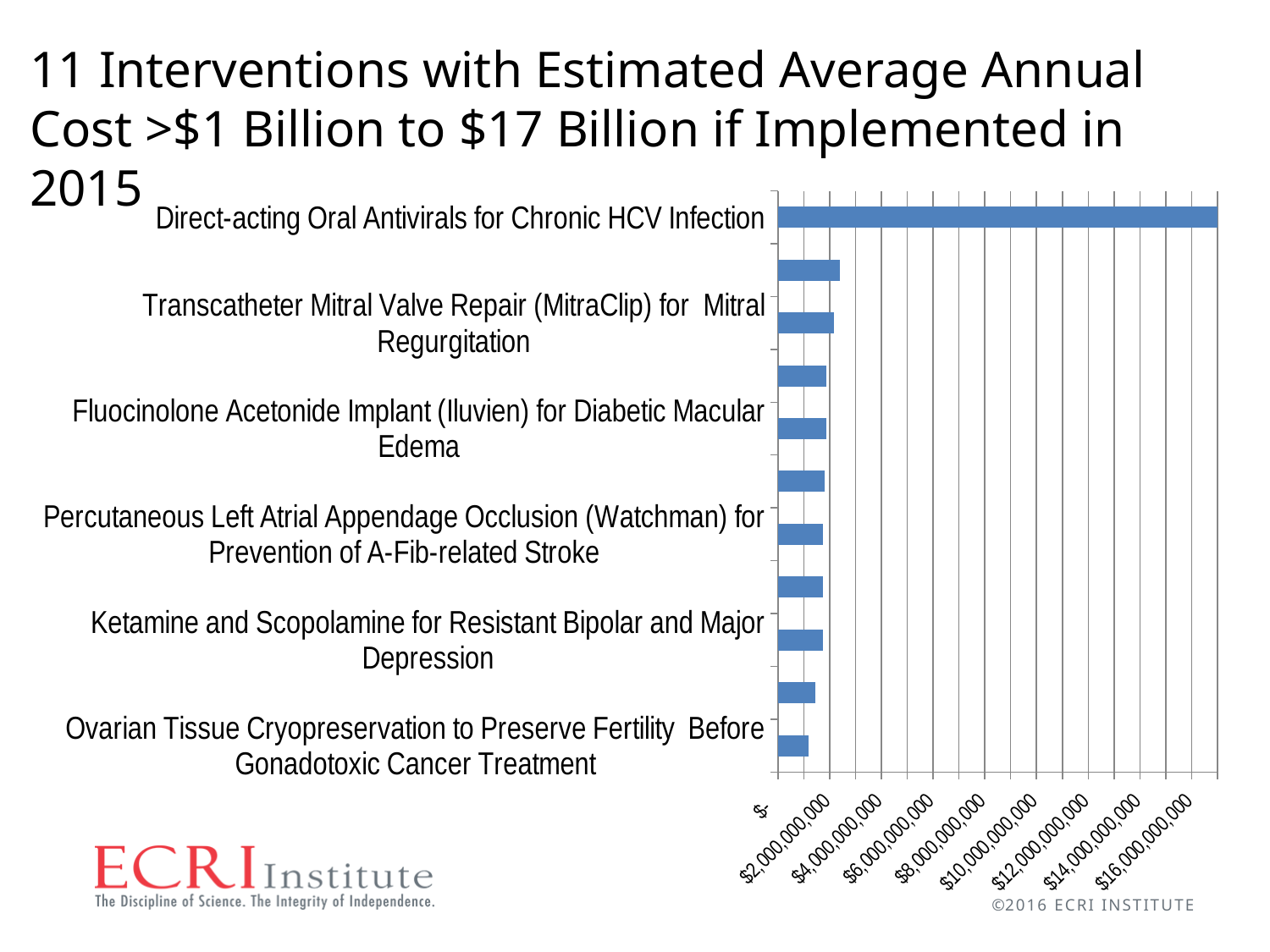
What colour are the bars in the chart? Blue Which labelled intervention has the lowest estimated average annual cost in the chart? Ovarian Tissue Cryopreservation to Preserve Fertility Before Gonadotoxic Cancer Treatment What kind of chart is shown on the slide? Bar chart Which intervention has the highest estimated average annual cost in the chart? Direct-acting Oral Antivirals for Chronic HCV Infection How many bars are plotted in the chart? 11 Is the value for Ovarian Tissue Cryopreservation to Preserve Fertility Before Gonadotoxic Cancer Treatment greater or less than $2,000,000,000? less Which is larger: the value for Direct-acting Oral Antivirals for Chronic HCV Infection or the value for Transcatheter Mitral Valve Repair (MitraClip) for Mitral Regurgitation? Direct-acting Oral Antivirals for Chronic HCV Infection Is the value for Transcatheter Mitral Valve Repair (MitraClip) for Mitral Regurgitation greater or less than $4,000,000,000? less Is the value for Direct-acting Oral Antivirals for Chronic HCV Infection greater or less than $16,000,000,000? greater Which is larger: the value for Ketamine and Scopolamine for Resistant Bipolar and Major Depression or the value for Ovarian Tissue Cryopreservation to Preserve Fertility Before Gonadotoxic Cancer Treatment? Ketamine and Scopolamine for Resistant Bipolar and Major Depression What is the highest tick label shown on the x axis of the chart? $16,000,000,000